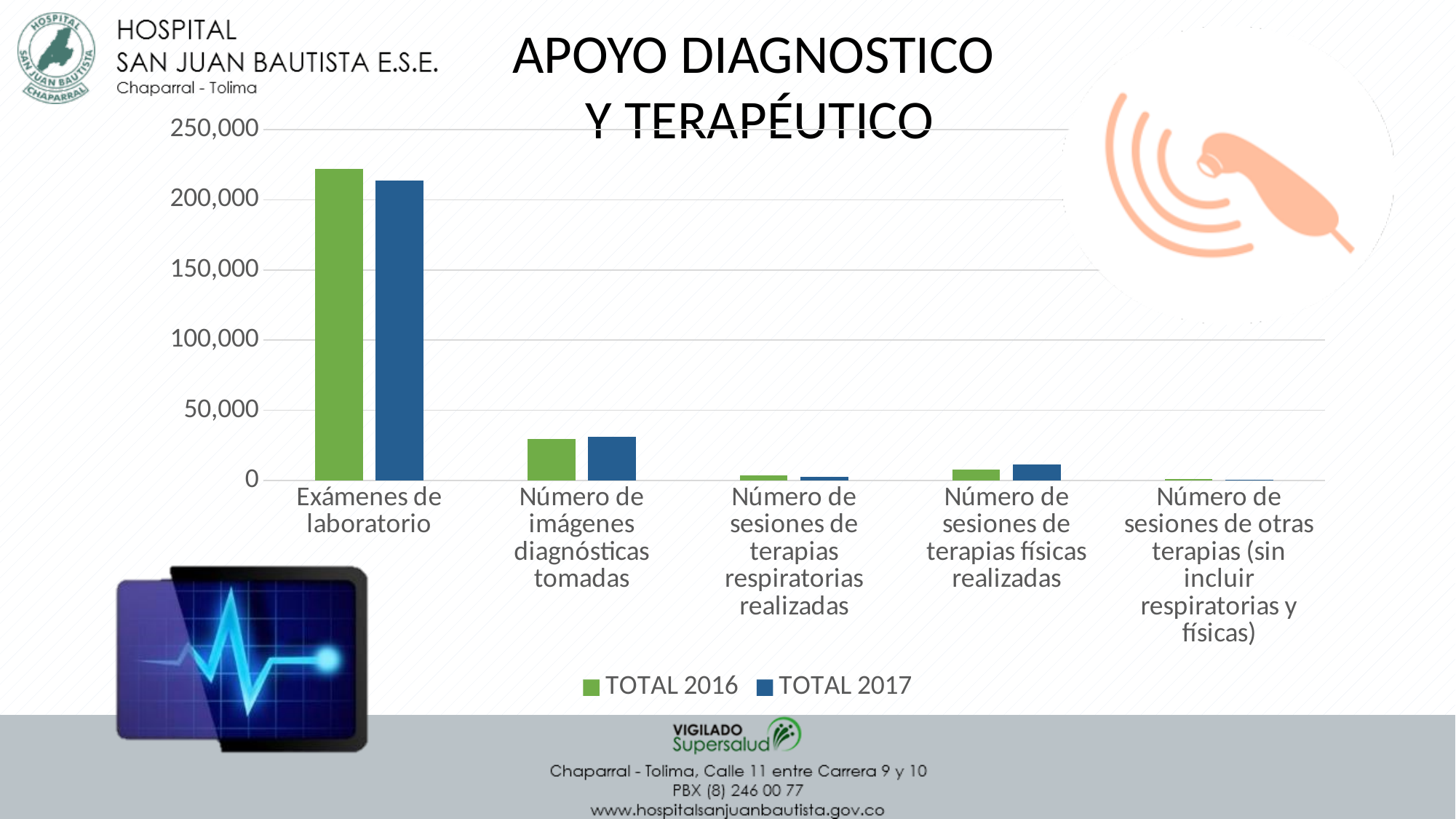
Is the TOTAL 2016 value for Exámenes de laboratorio greater or less than 200,000? greater Is the TOTAL 2017 value for Exámenes de laboratorio greater or less than 250,000? less Which colour represents the TOTAL 2017 series in the legend? blue How many categories are shown on the x axis? 5 For Exámenes de laboratorio, which series has the larger value, TOTAL 2016 or TOTAL 2017? TOTAL 2016 For Número de sesiones de terapias físicas realizadas, which series has the larger value, TOTAL 2016 or TOTAL 2017? TOTAL 2017 Which category has the highest value for TOTAL 2016? Exámenes de laboratorio Is the TOTAL 2016 value for Número de imágenes diagnósticas tomadas greater or less than 50,000? less How many series does the legend list? 2 Which category has the lowest value for TOTAL 2016? Número de sesiones de otras terapias (sin incluir respiratorias y físicas) What kind of chart is shown on the slide? bar chart Which category has the highest value for TOTAL 2017? Exámenes de laboratorio